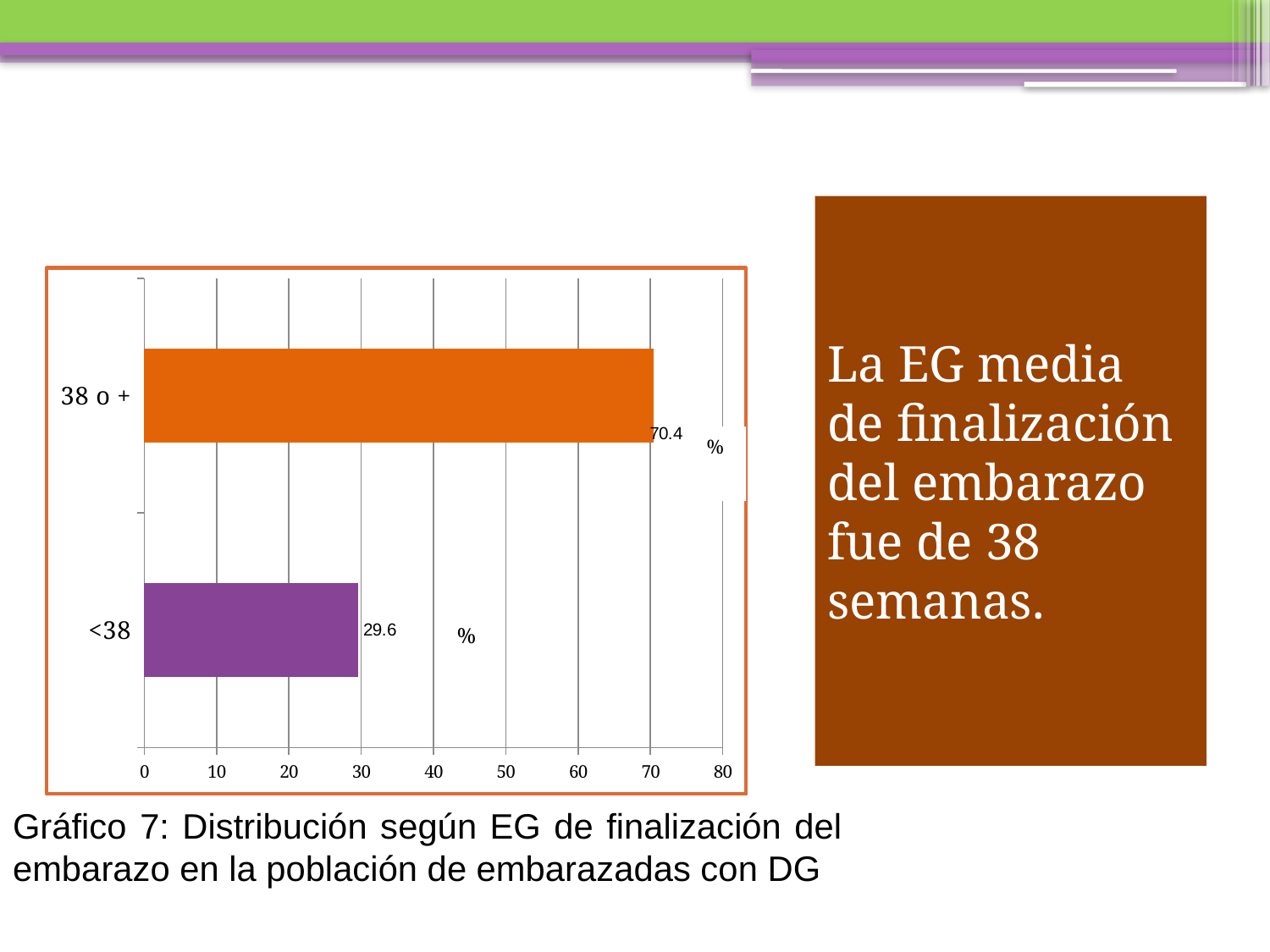
What is the difference between the values for "38 o +" and "<38"? 40.8 What is the value for the "38 o +" category? 70.4 Which category has the highest value? 38 o + Which category has the lowest value? <38 How many categories are shown in the chart? 2 What is the value for the "<38" category? 29.6 Is the value for "38 o +" greater or less than 70? greater Is the value for "<38" greater or less than 30? less What kind of chart is shown on the slide? bar chart Which is larger, the value for "38 o +" or the value for "<38"? 38 o + What colour is the bar for the "<38" category? purple What is the maximum value shown on the horizontal axis? 80